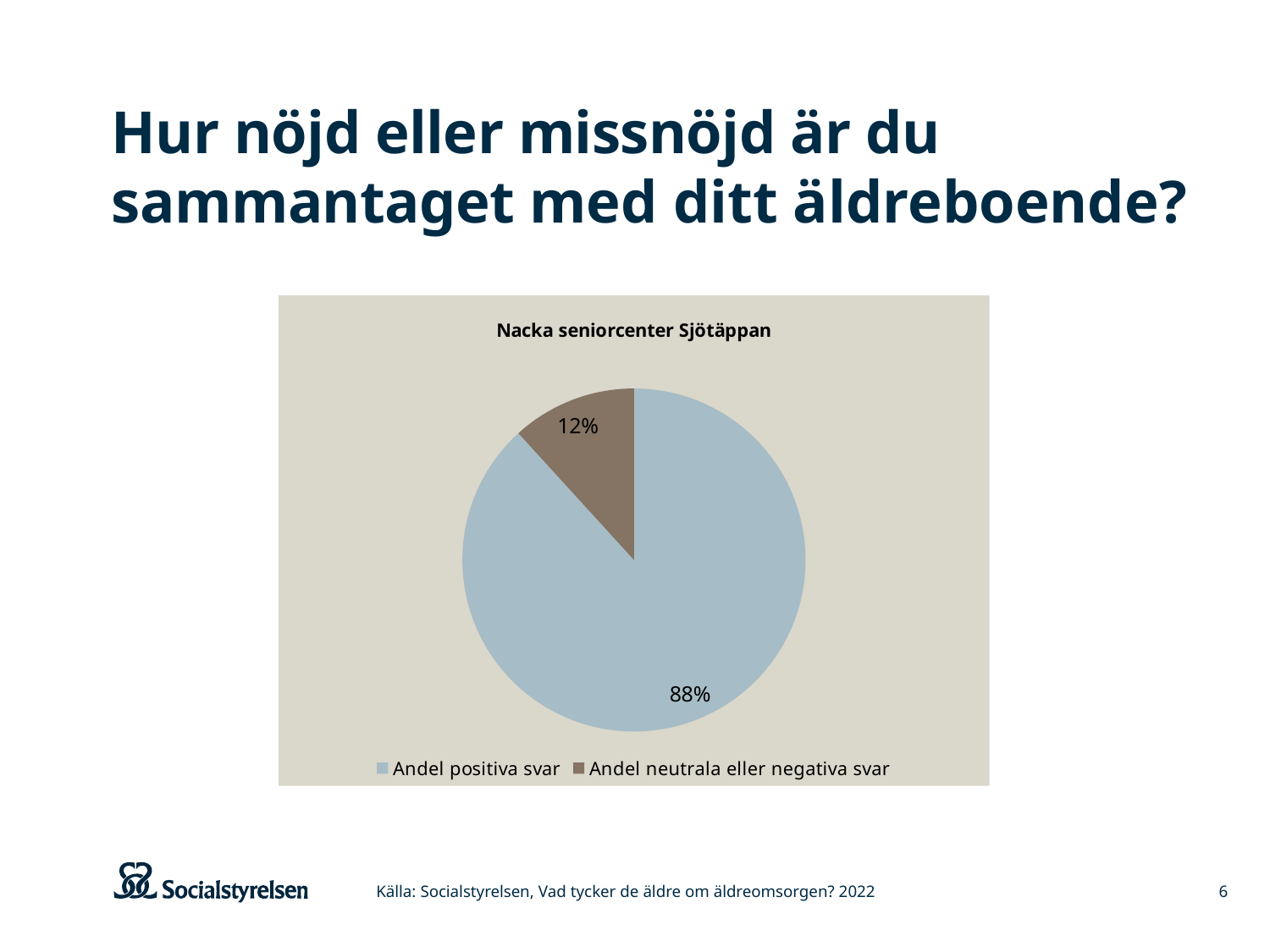
Which slice is the largest in the pie chart? Andel positiva svar What colour is the 'Andel neutrala eller negativa svar' slice? Brown What is the title of the chart? Nacka seniorcenter Sjötäppan How many entries does the legend list? 2 Which slice is the smallest in the pie chart? Andel neutrala eller negativa svar What share of the pie is 'Andel positiva svar'? 88% Which is larger, 'Andel positiva svar' or 'Andel neutrala eller negativa svar'? Andel positiva svar What is the total of the two slices in the pie chart? 100% What is the difference in percentage points between 'Andel positiva svar' and 'Andel neutrala eller negativa svar'? 76 percentage points How many slices does the pie chart have? 2 What kind of chart is shown on the slide? Pie chart What share of the pie is 'Andel neutrala eller negativa svar'? 12%